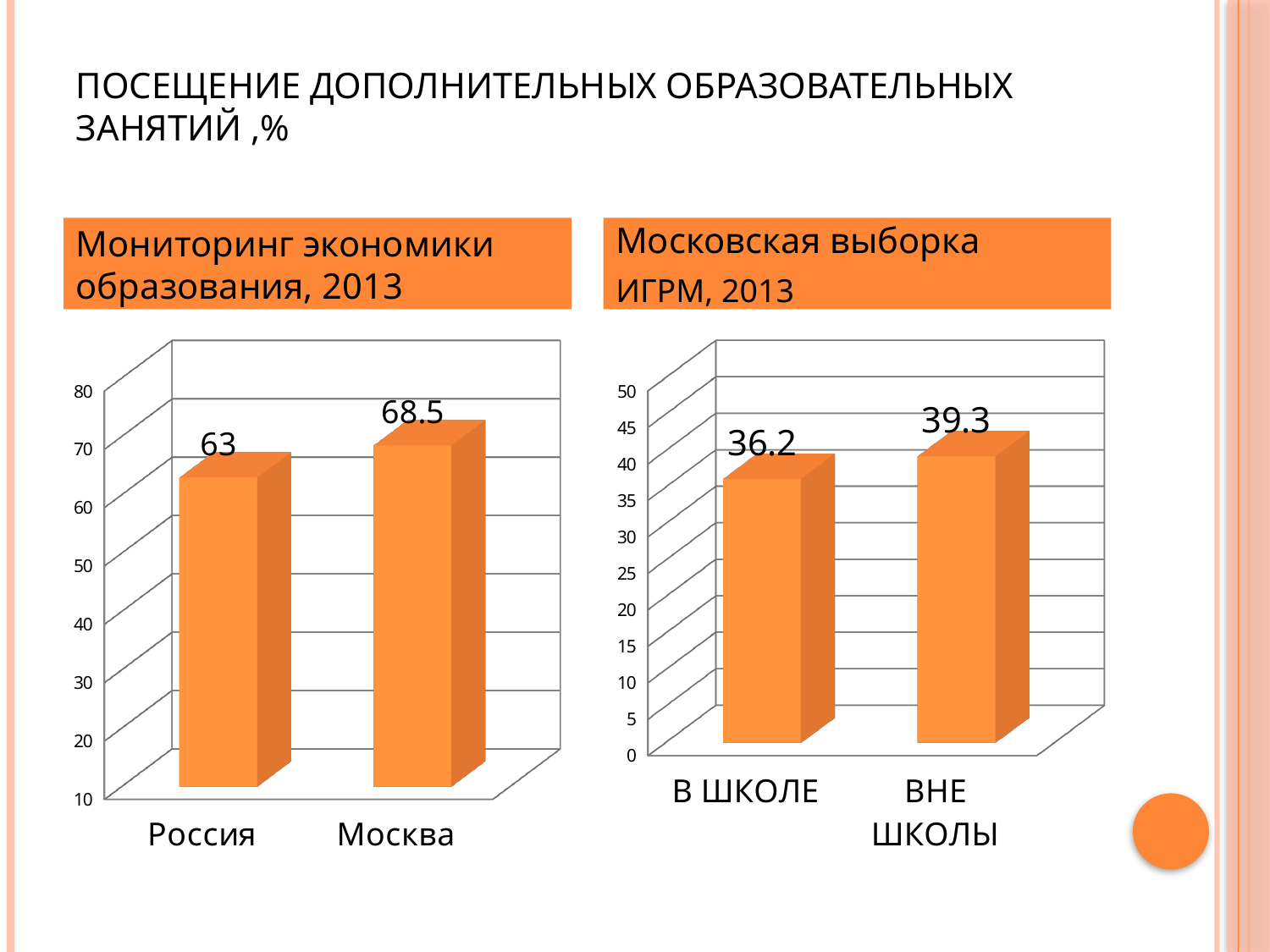
In the left chart (Мониторинг экономики образования, 2013), which category has the higher value? Москва What kind of chart is the right chart (Московская выборка ИГРМ, 2013)? bar chart In the right chart (Московская выборка ИГРМ, 2013), which category has the lower value? В ШКОЛЕ How many categories are shown in the left chart (Мониторинг экономики образования, 2013)? 2 In the right chart (Московская выборка ИГРМ, 2013), what is the difference between the values for ВНЕ ШКОЛЫ and В ШКОЛЕ? 3.1 In the left chart (Мониторинг экономики образования, 2013), what is the value for Москва? 68.5 In the right chart (Московская выборка ИГРМ, 2013), is the value for В ШКОЛЕ greater or less than 40? less In the right chart (Московская выборка ИГРМ, 2013), what is the value for ВНЕ ШКОЛЫ? 39.3 In the left chart (Мониторинг экономики образования, 2013), what is the value for Россия? 63 In the right chart (Московская выборка ИГРМ, 2013), what is the value for В ШКОЛЕ? 36.2 What is the title of the slide? ПОСЕЩЕНИЕ ДОПОЛНИТЕЛЬНЫХ ОБРАЗОВАТЕЛЬНЫХ ЗАНЯТИЙ ,% In the left chart (Мониторинг экономики образования, 2013), what is the difference between the values for Москва and Россия? 5.5